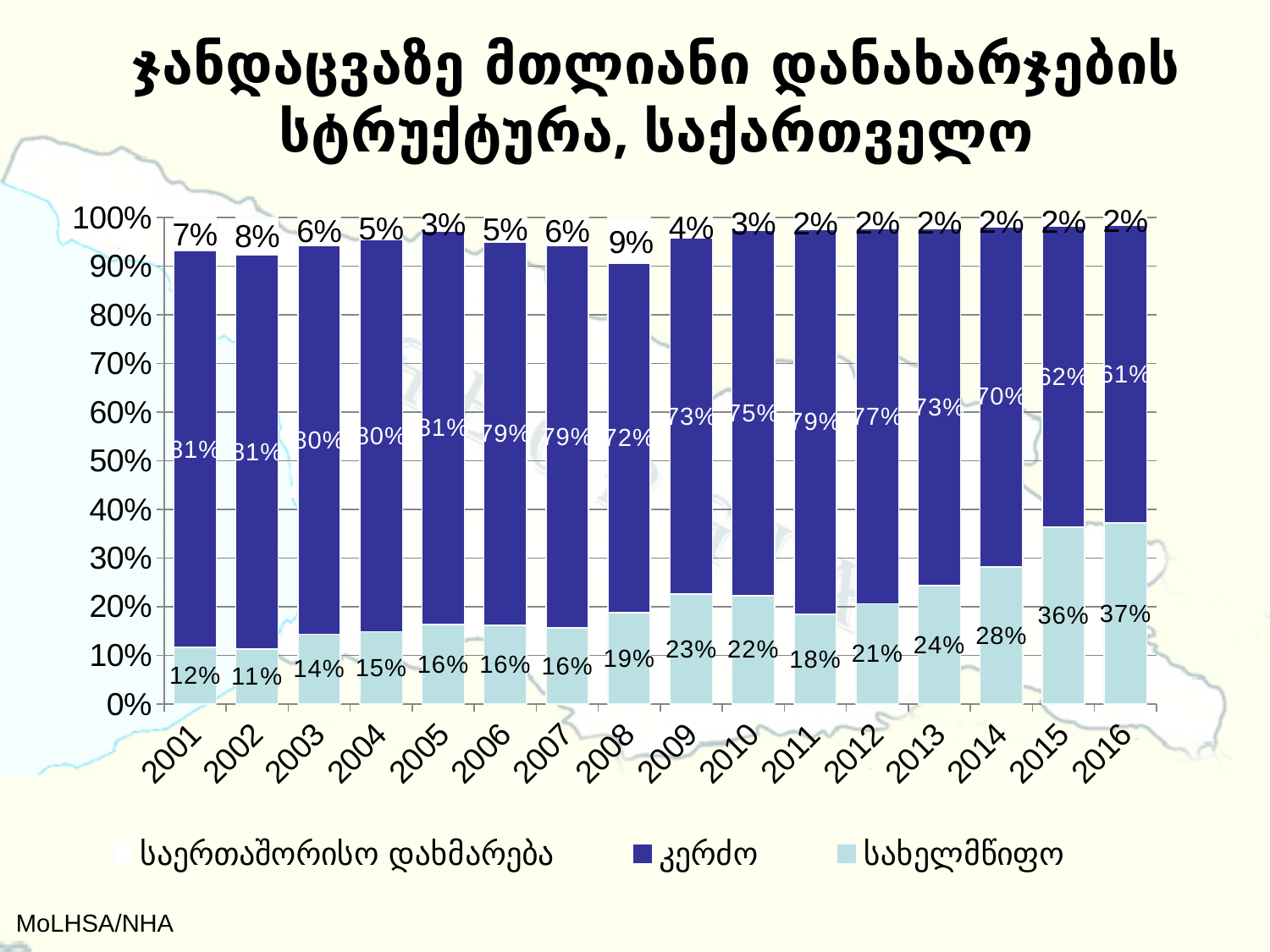
What kind of chart is shown on the slide? Stacked bar chart How many years are shown on the x axis? 16 Which is larger: the კერძო segment in 2001 or in 2016? 2001 By how many percentage points does the სახელმწიფო segment in 2016 exceed that in 2001? 25 percentage points In which year is the სახელმწიფო segment the highest? 2016 In which year is the კერძო segment the lowest? 2016 In which year is the საერთაშორისო დახმარება segment the highest? 2008 What is the value of the კერძო (dark blue) segment for 2008? 72% What is the value of the სახელმწიფო (light blue) segment for 2016? 37% How many series does the legend list? 3 What is the value of the საერთაშორისო დახმარება segment for 2002? 8% In which year is the სახელმწიფო segment the lowest? 2002